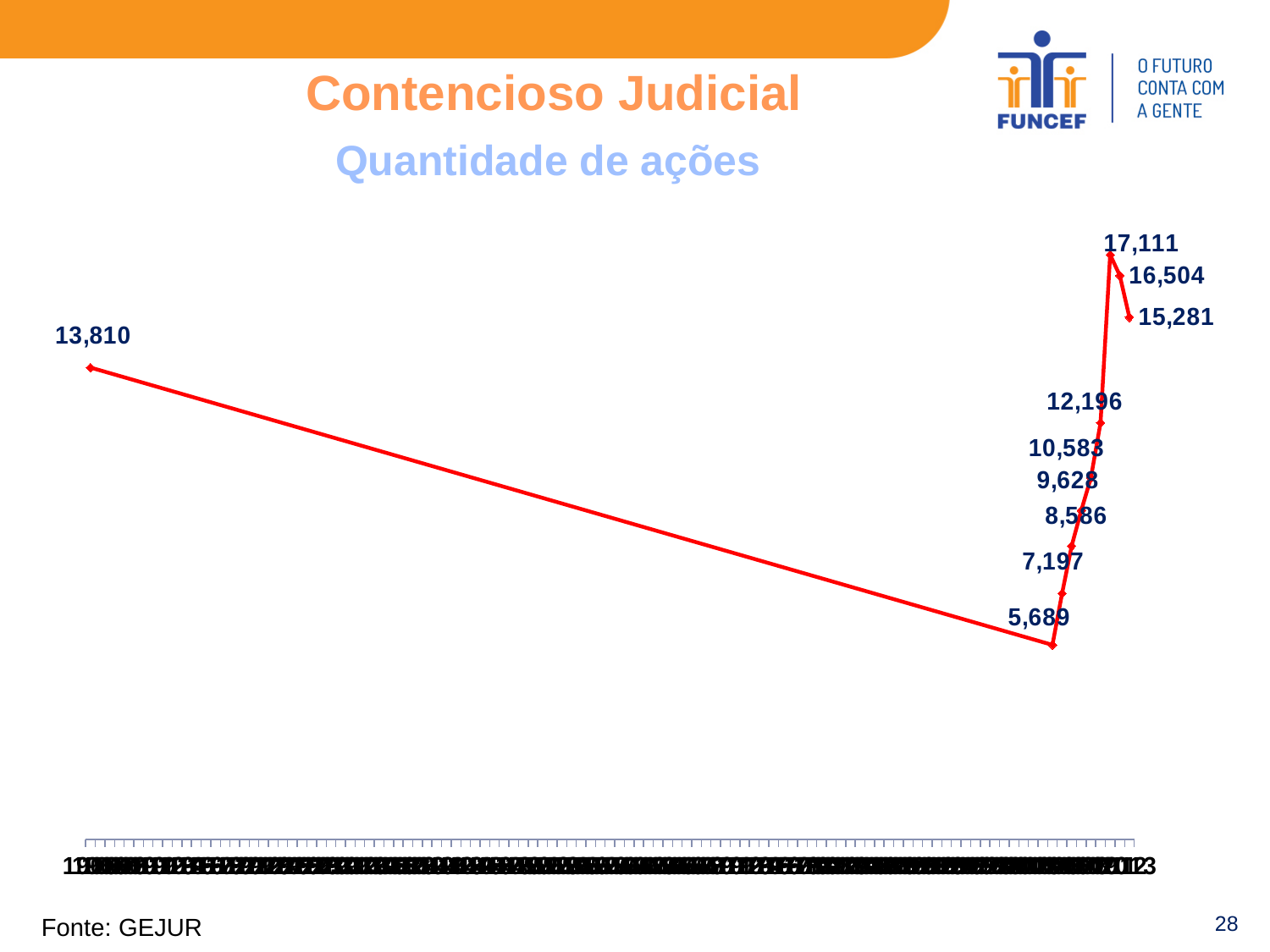
What is the difference between the values 16,504 and 15,281? 1,223 Which is larger, the first point's value of 13,810 or the last point's value of 15,281? 15,281 What is the highest value labelled on the chart? 17,111 What is the subtitle of the chart shown below the title 'Contencioso Judicial'? Quantidade de ações What is the lowest value labelled on the chart? 5,689 What is the value of the leftmost (first) point on the line? 13,810 What is the difference between the peak value 17,111 and the next point 16,504? 607 What is the difference between the highest labelled value (17,111) and the lowest labelled value (5,689)? 11,422 What kind of chart is shown on the slide? line chart What is the value of the rightmost (last) point on the line? 15,281 After reaching the peak of 17,111, do the values rise or fall over the last three points? fall How many data points are labelled with values on the chart? 10